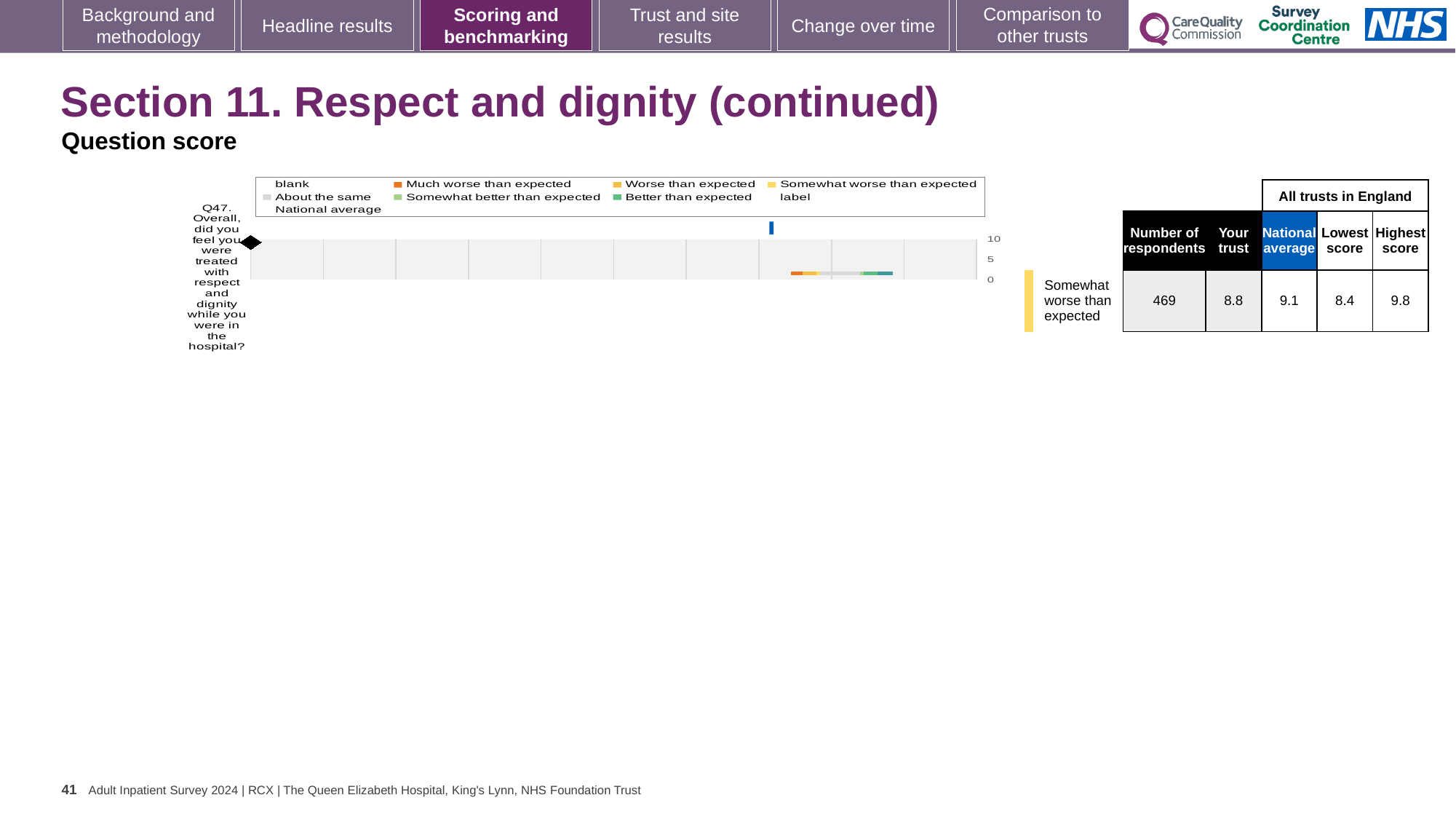
In the table beside the chart, what is the number of respondents for Q47? 469 What benchmark category is the trust's Q47 score assigned to, according to the label beside the table? Somewhat worse than expected In the table beside the chart, what is the lowest score among all trusts in England for Q47? 8.4 Which is larger for Q47, the 'Your trust' score or the national average? National average In the table beside the chart, what is the national average score for Q47? 9.1 Which question is plotted on the chart? Q47. Overall, did you feel you were treated with respect and dignity while you were in the hospital? How many survey questions are plotted on the chart? 1 What kind of chart is shown on the slide? bar chart In the table beside the chart, what is the highest score among all trusts in England for Q47? 9.8 What is the highest tick value shown on the chart's axis? 10 What is the difference between the highest score and the lowest score for Q47 in the table? 1.4 In the table beside the chart, what is the 'Your trust' score for Q47? 8.8